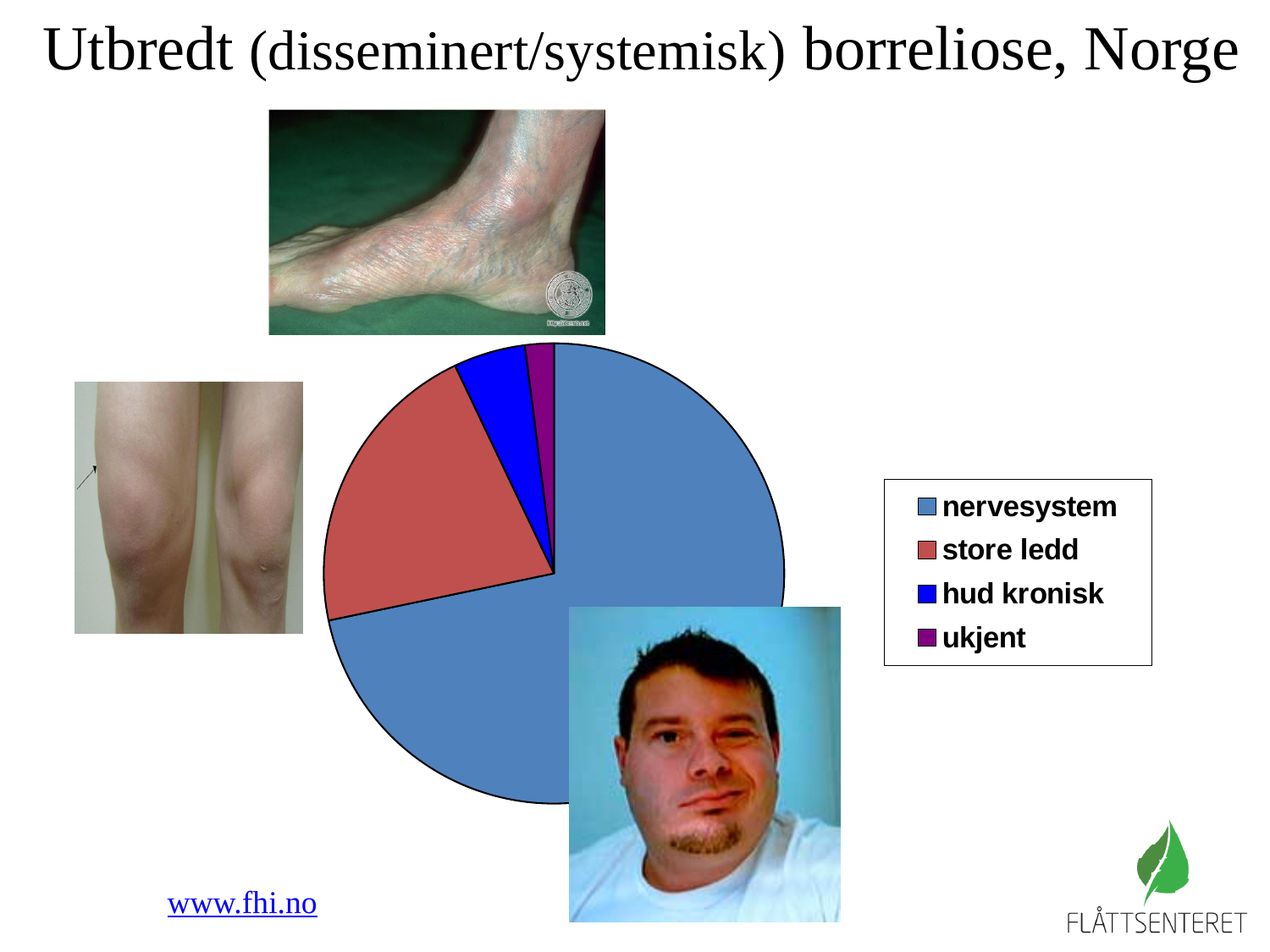
Which slice is larger in the pie chart, hud kronisk or ukjent? hud kronisk What kind of chart is shown on the slide? pie chart Which category has the second-largest slice in the pie chart? store ledd How many slices does the pie chart have? 4 Which category has the largest slice in the pie chart? nervesystem Which slice is larger in the pie chart, nervesystem or store ledd? nervesystem How many entries does the legend of the pie chart list? 4 Which category has the smallest slice in the pie chart? ukjent What colour is the slice for hud kronisk in the pie chart? blue What colour is the slice for ukjent in the pie chart? purple Which slice is larger in the pie chart, store ledd or hud kronisk? store ledd